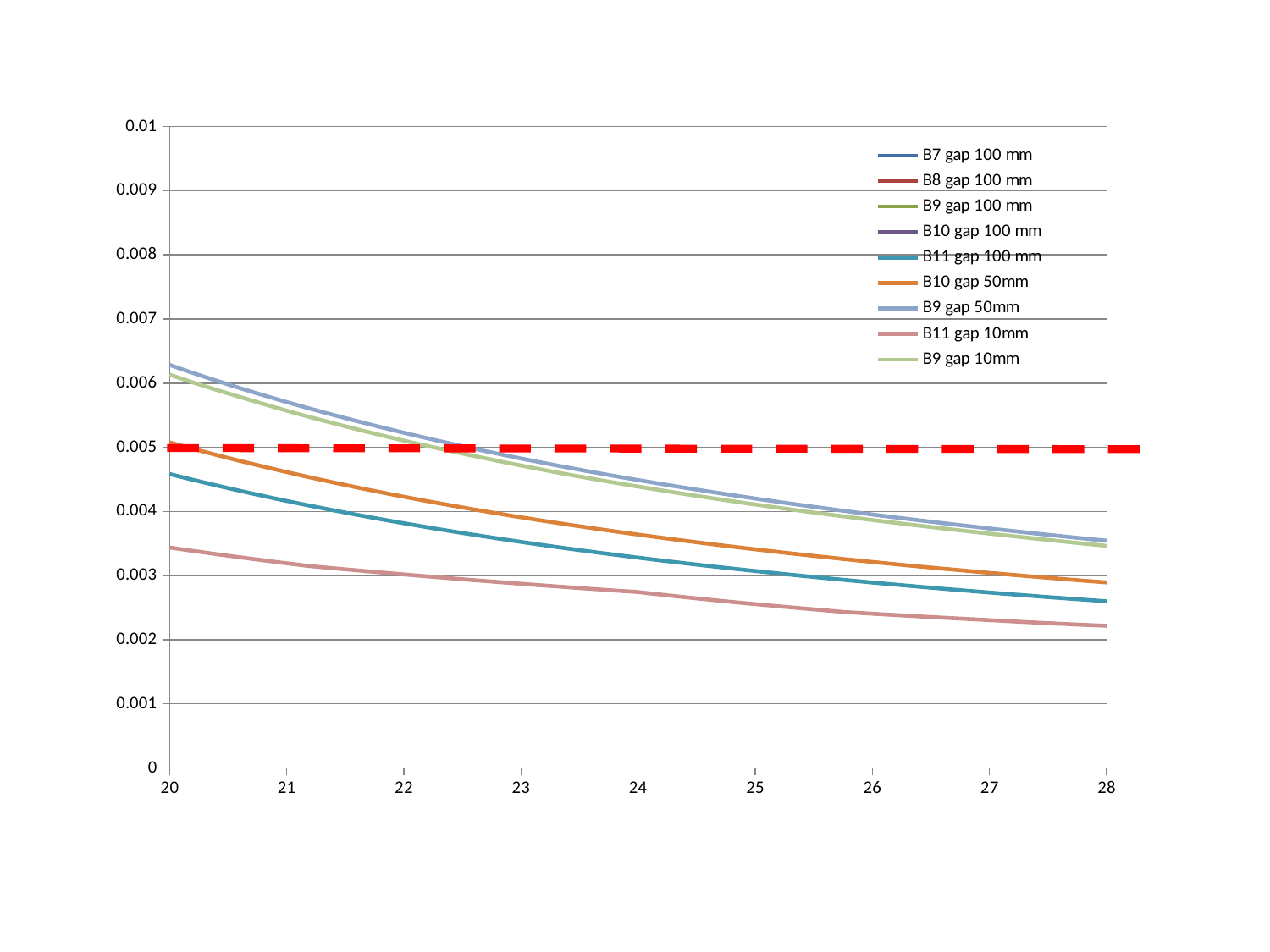
Is the value for B11 gap 10mm at x = 28 greater or less than 0.003? less What is the first entry listed in the legend? B7 gap 100 mm Do the plotted lines rise or fall as the x-axis value increases from 20 to 28? fall What kind of chart is shown on the slide? line chart Is the value for B9 gap 10mm at x = 28 greater or less than 0.004? less Is the value for B11 gap 100 mm at x = 20 greater or less than 0.004? greater At x = 20, which is larger: B9 gap 50mm or B11 gap 10mm? B9 gap 50mm At what y-axis level is the red dashed horizontal line drawn? 0.005 How many series does the legend list? 9 Which series has the lowest value at x = 28? B11 gap 10mm